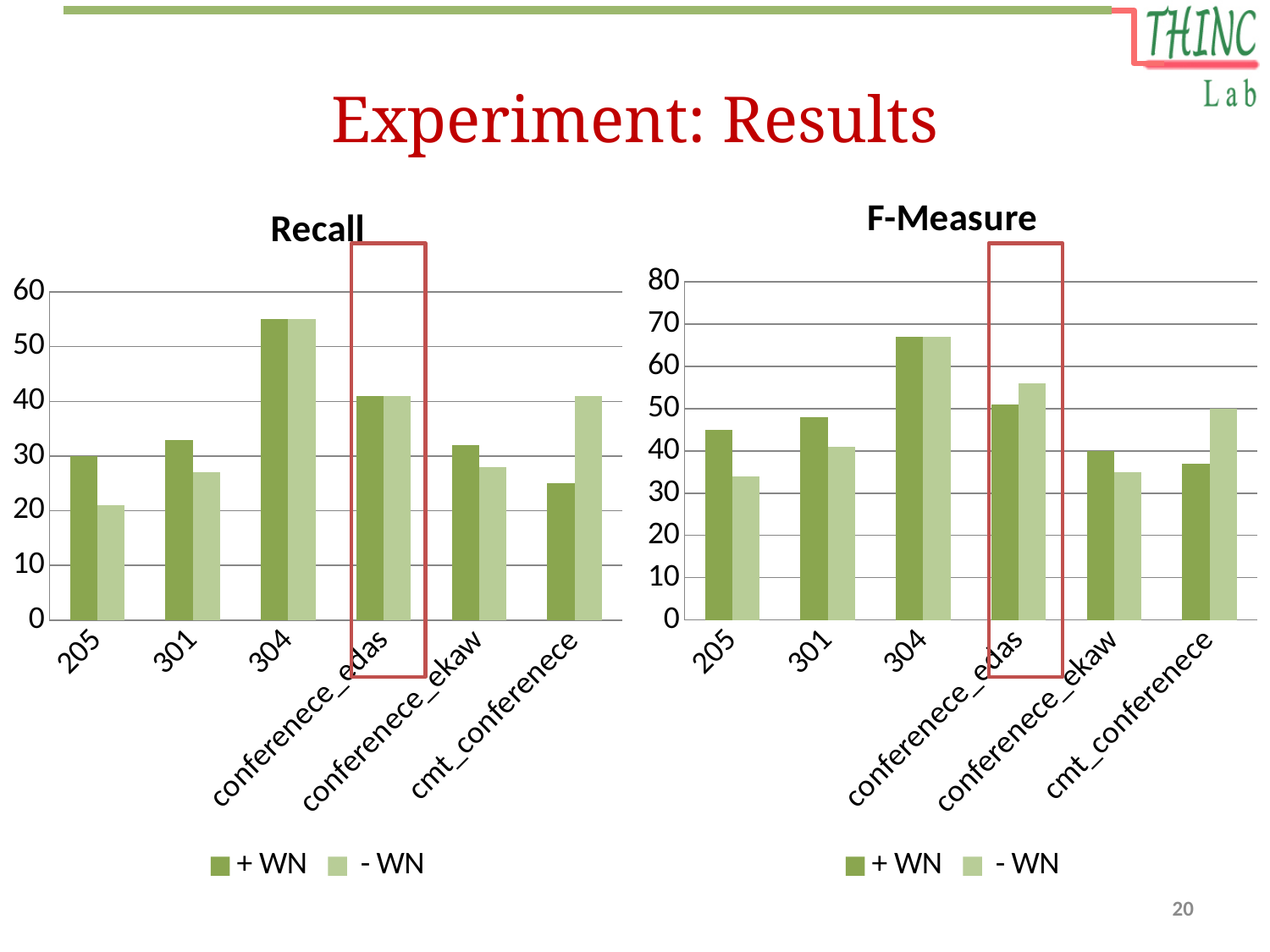
In the F-Measure chart, is the - WN value for conferenece_ekaw greater or less than 40? less In the Recall chart, is the - WN value for 205 greater or less than 30? less In the F-Measure chart, for 205, which series has the larger value, + WN or - WN? + WN In the F-Measure chart, which category has the highest - WN bar? 304 In the Recall chart, is the + WN value for 304 greater or less than 50? greater In the Recall chart, which category has the highest + WN bar? 304 What kind of chart is the Recall chart? bar chart In the Recall chart, for cmt_conferenece, which series has the larger value, + WN or - WN? - WN How many categories are shown on the x axis of the Recall chart? 6 In the Recall chart, which category has the lowest - WN bar? 205 How many series does the legend of the F-Measure chart list? 2